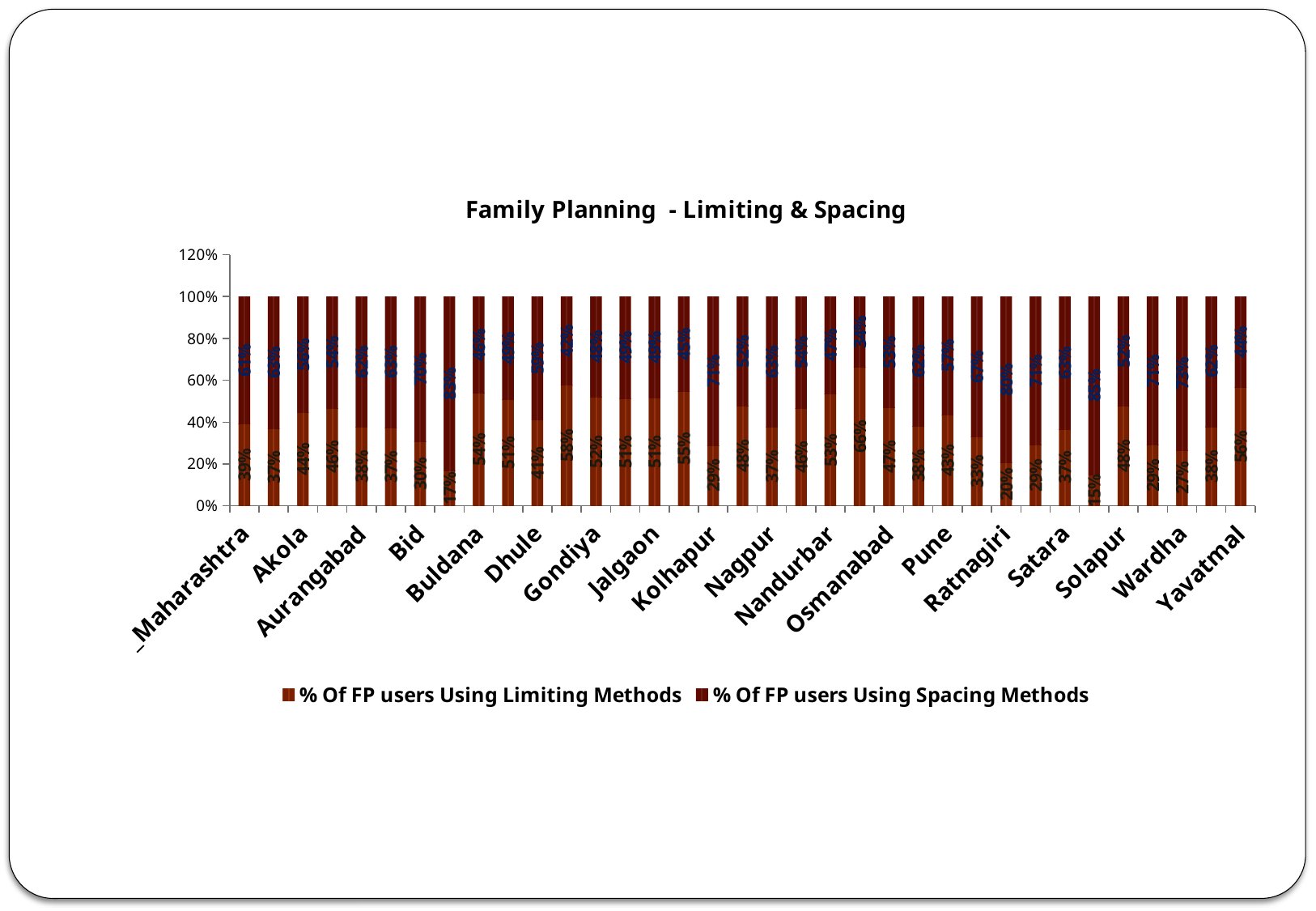
What are the two series named in the legend? % Of FP users Using Limiting Methods; % Of FP users Using Spacing Methods What is the title of the chart? Family Planning - Limiting & Spacing How many series does the legend list? 2 What is the % of FP users using limiting methods for Ratnagiri? 20% What is the difference between the % of FP users using limiting methods for Nandurbar and for Wardha? 26% What is the total height of each stacked bar on the chart? 100% Is the % of FP users using spacing methods for Kolhapur greater or less than 60%? greater What is the % of FP users using limiting methods for Yavatmal? 56% What kind of chart is shown on the slide? stacked bar chart What is the % of FP users using limiting methods for Buldana? 54% Which has a higher % of FP users using limiting methods, Bid or Gondiya? Gondiya What is the % of FP users using limiting methods for _Maharashtra? 39%